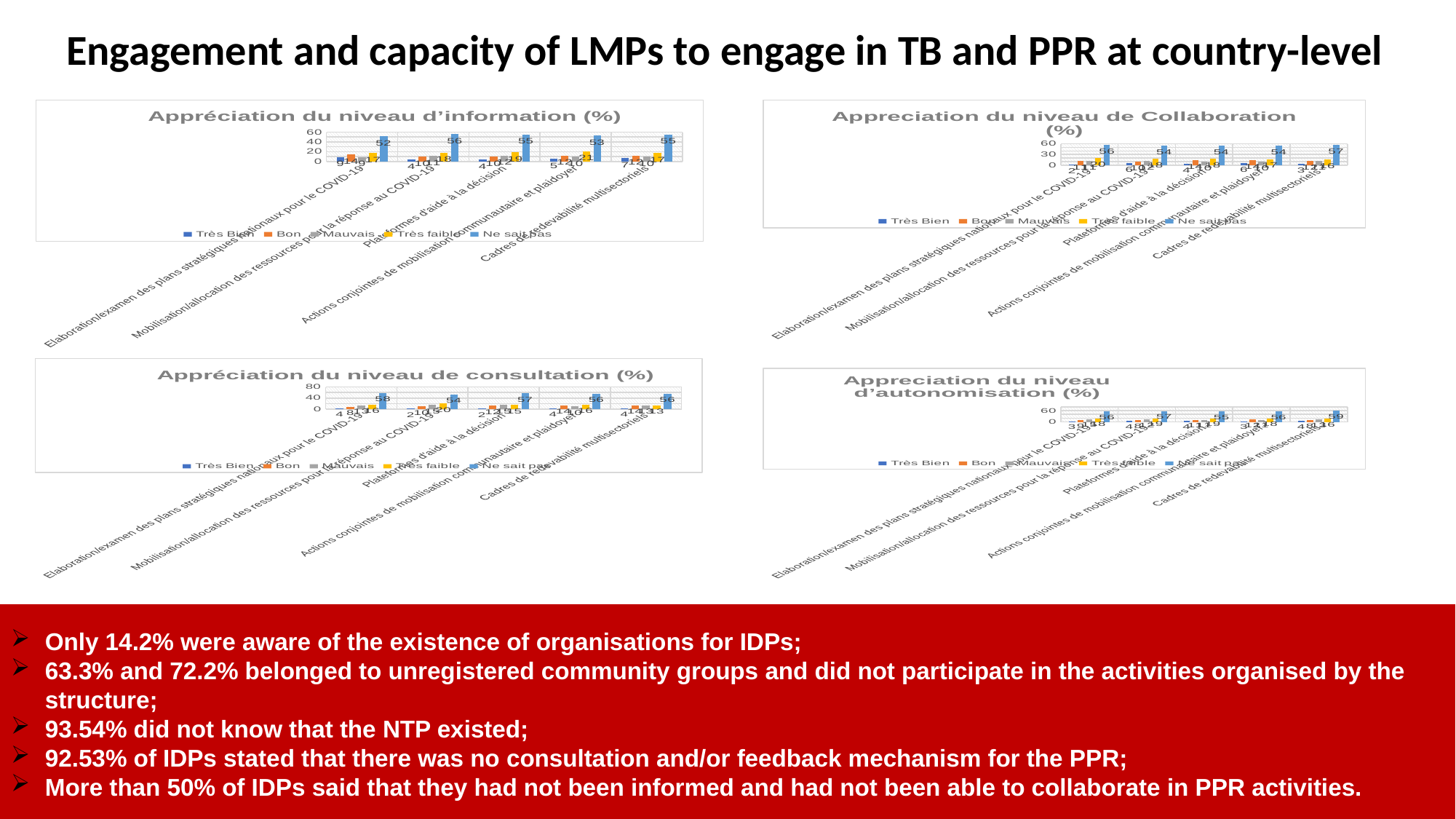
How many series does the legend of the 'Appréciation du niveau d'information (%)' chart list? 5 In the 'Appréciation du niveau de consultation (%)' chart, what is the difference between the 'Ne sait pas' values for 'Elaboration/examen des plans stratégiques nationaux pour le COVID-19' and 'Mobilisation/allocation des ressources pour la réponse au COVID-19'? 4 In the 'Appréciation du niveau d'information (%)' chart, what is the 'Ne sait pas' value for 'Mobilisation/allocation des ressources pour la réponse au COVID-19'? 56 In the 'Appreciation du niveau de Collaboration (%)' chart, what is the 'Ne sait pas' value for 'Cadres de redevabilité multisectoriels'? 57 In the 'Appreciation du niveau de Collaboration (%)' chart, which category has the highest 'Ne sait pas' value? Cadres de redevabilité multisectoriels How many categories are shown on the x axis of the 'Appréciation du niveau de consultation (%)' chart? 5 How many charts are shown on the slide? 4 In the 'Appréciation du niveau d'information (%)' chart, which has the larger 'Ne sait pas' value: 'Elaboration/examen des plans stratégiques nationaux pour le COVID-19' or 'Cadres de redevabilité multisectoriels'? Cadres de redevabilité multisectoriels In the 'Appreciation du niveau d'autonomisation (%)' chart, what is the 'Ne sait pas' value for 'Cadres de redevabilité multisectoriels'? 59 In the 'Appréciation du niveau de consultation (%)' chart, what is the 'Ne sait pas' value for 'Elaboration/examen des plans stratégiques nationaux pour le COVID-19'? 58 In the 'Appréciation du niveau d'information (%)' chart, which category has the lowest 'Ne sait pas' value? Elaboration/examen des plans stratégiques nationaux pour le COVID-19 What kind of chart is the 'Appréciation du niveau d'information (%)' chart? bar chart